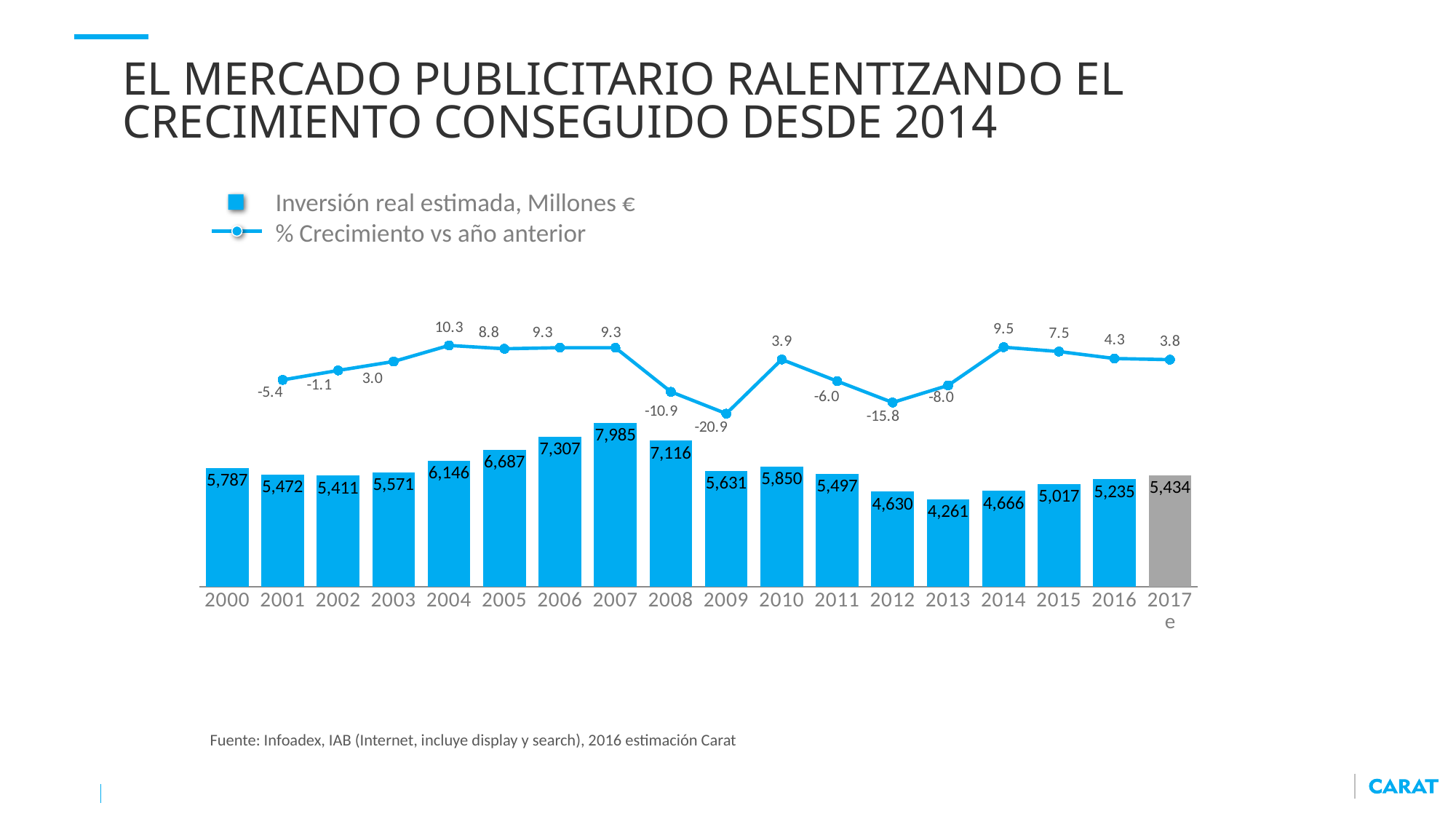
Which year has the lowest estimated real investment? 2013 What is the % Crecimiento vs año anterior value for 2009? -20.9 What is the estimated real investment shown for 2017e? 5,434 What is the difference in estimated real investment between 2007 and 2008? 869 How many years (bars) are shown on the x axis? 18 Which year has the highest estimated real investment? 2007 Which year has the highest % Crecimiento vs año anterior value? 2004 What is the estimated real investment (Inversión real estimada) for 2007? 7,985 Which bar is coloured grey instead of blue? 2017e How many series does the legend list? 2 Which year has the larger estimated real investment, 2010 or 2016? 2010 Does the estimated real investment rise or fall from 2013 to 2017e? rise